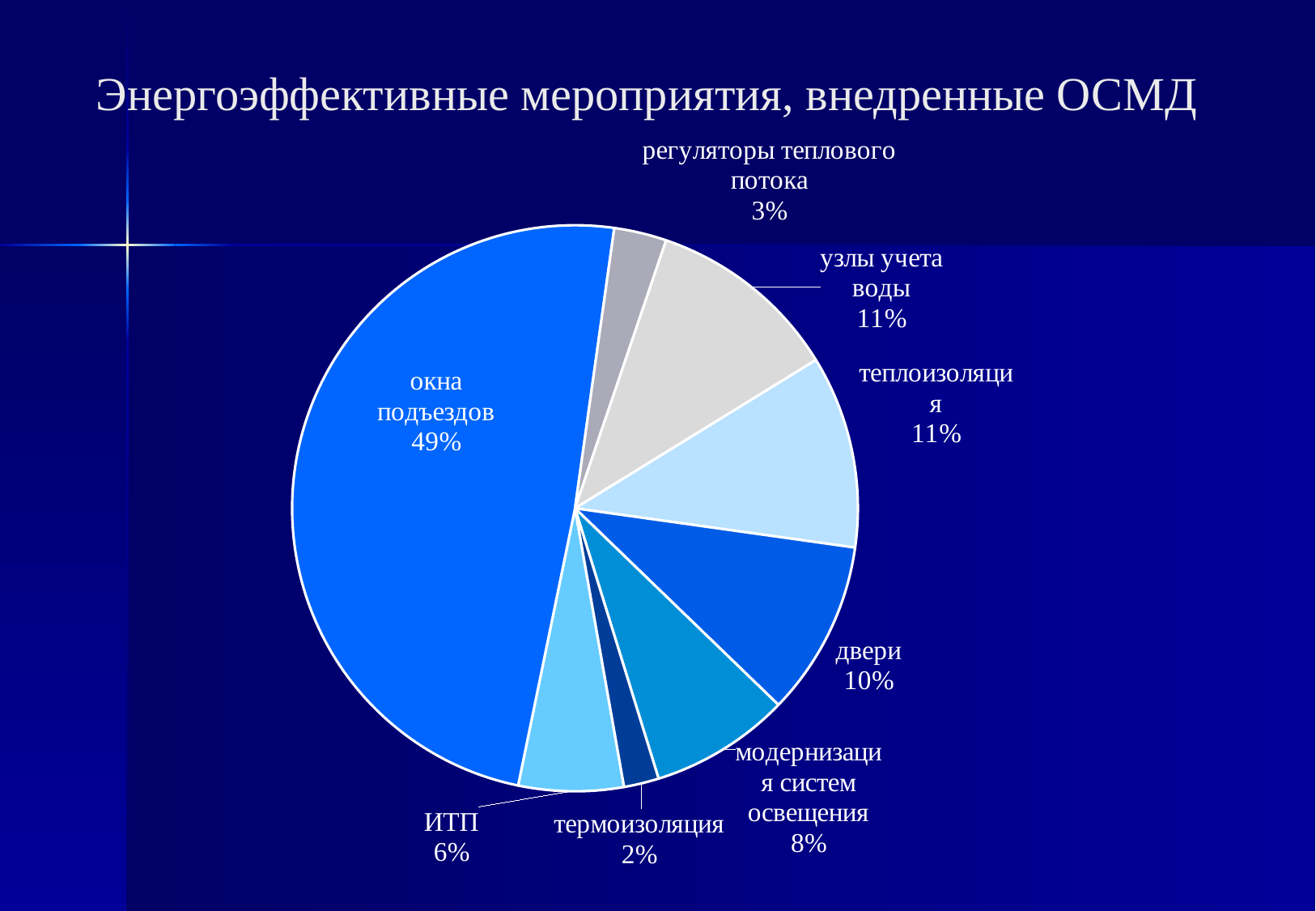
What share of the pie does "окна подъездов" have? 49% What kind of chart is shown on the slide? pie chart Which category has the smallest slice of the pie? термоизоляция Which category has the largest slice of the pie? окна подъездов What is the value shown for "двери"? 10% What is the difference in percentage points between "окна подъездов" and "узлы учета воды"? 38 How many slices does the pie chart have? 8 What is the title of the slide? Энергоэффективные мероприятия, внедренные ОСМД What is the value shown for "регуляторы теплового потока"? 3% Which is larger, the share for "двери" or the share for "ИТП"? двери What is the value shown for "модернизация систем освещения"? 8% What is the value shown for "ИТП"? 6%